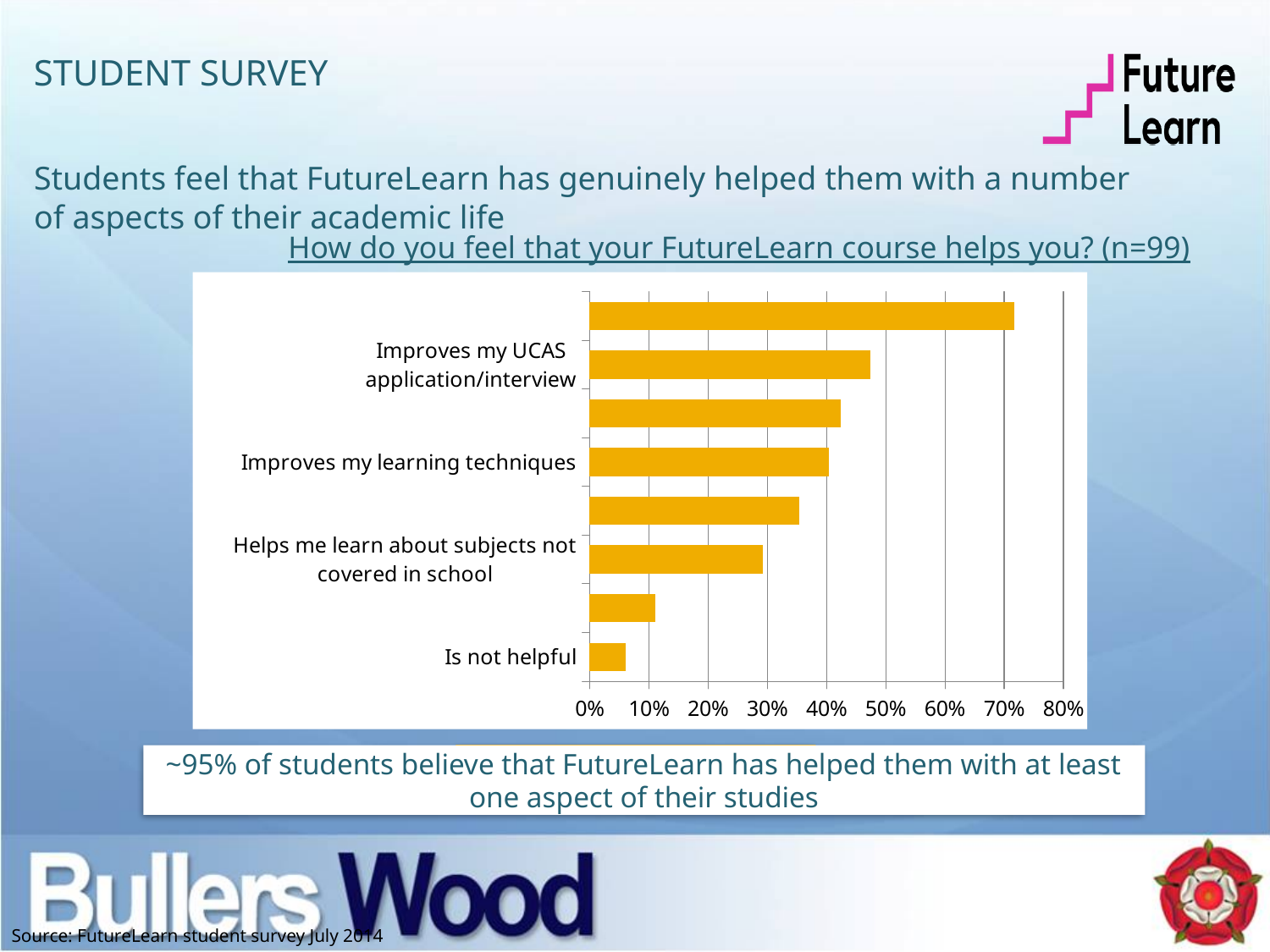
Is the value for 'Improves my UCAS application/interview' greater or less than 40%? greater Is the value for 'Improves my UCAS application/interview' greater or less than 50%? less Which category has the lowest value in the chart? Is not helpful Is the value for 'Is not helpful' greater or less than 10%? less Which is larger: the value for 'Helps me learn about subjects not covered in school' or 'Is not helpful'? Helps me learn about subjects not covered in school How many bars are plotted in the chart? 8 What is the highest value shown on the chart's horizontal axis? 80% Which is larger: the value for 'Improves my UCAS application/interview' or 'Improves my learning techniques'? Improves my UCAS application/interview What kind of chart is shown on the slide? bar chart What is the title of the chart? How do you feel that your FutureLearn course helps you? (n=99)